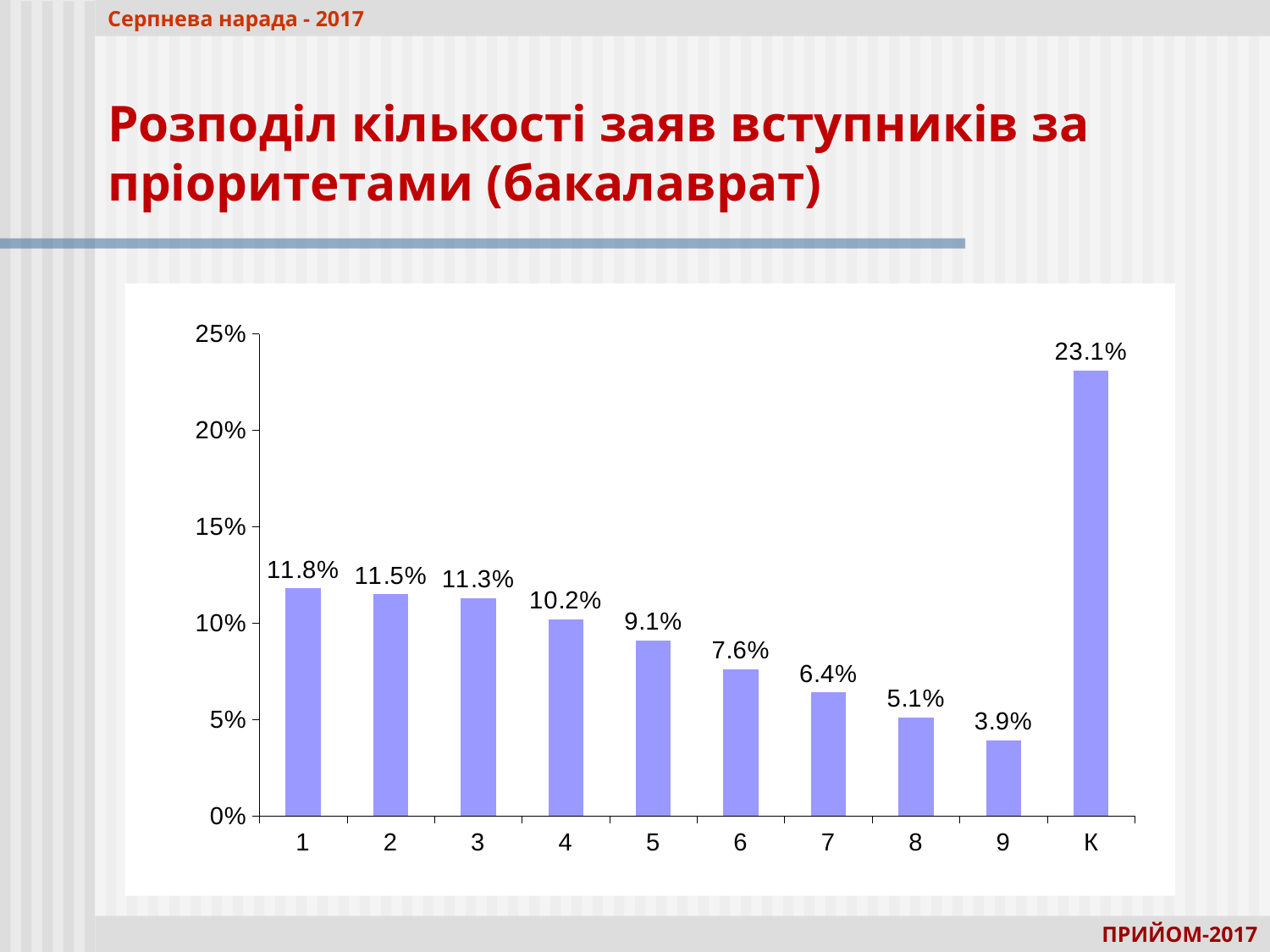
What kind of chart is shown? bar chart What is the value for priority 5? 9.1% Which category has the highest value? K What is the difference between the values for K and priority 1? 11.3% What is the value for priority 1? 11.8% Is the value for priority 3 greater or less than 10%? greater Which is larger, the value for priority 7 or priority 8? 7 What is the value for category K? 23.1% Do the values rise or fall from priority 1 to priority 9? fall How many categories are shown on the x axis? 10 What is the difference between the values for priority 4 and priority 6? 2.6% Which category has the lowest value? 9